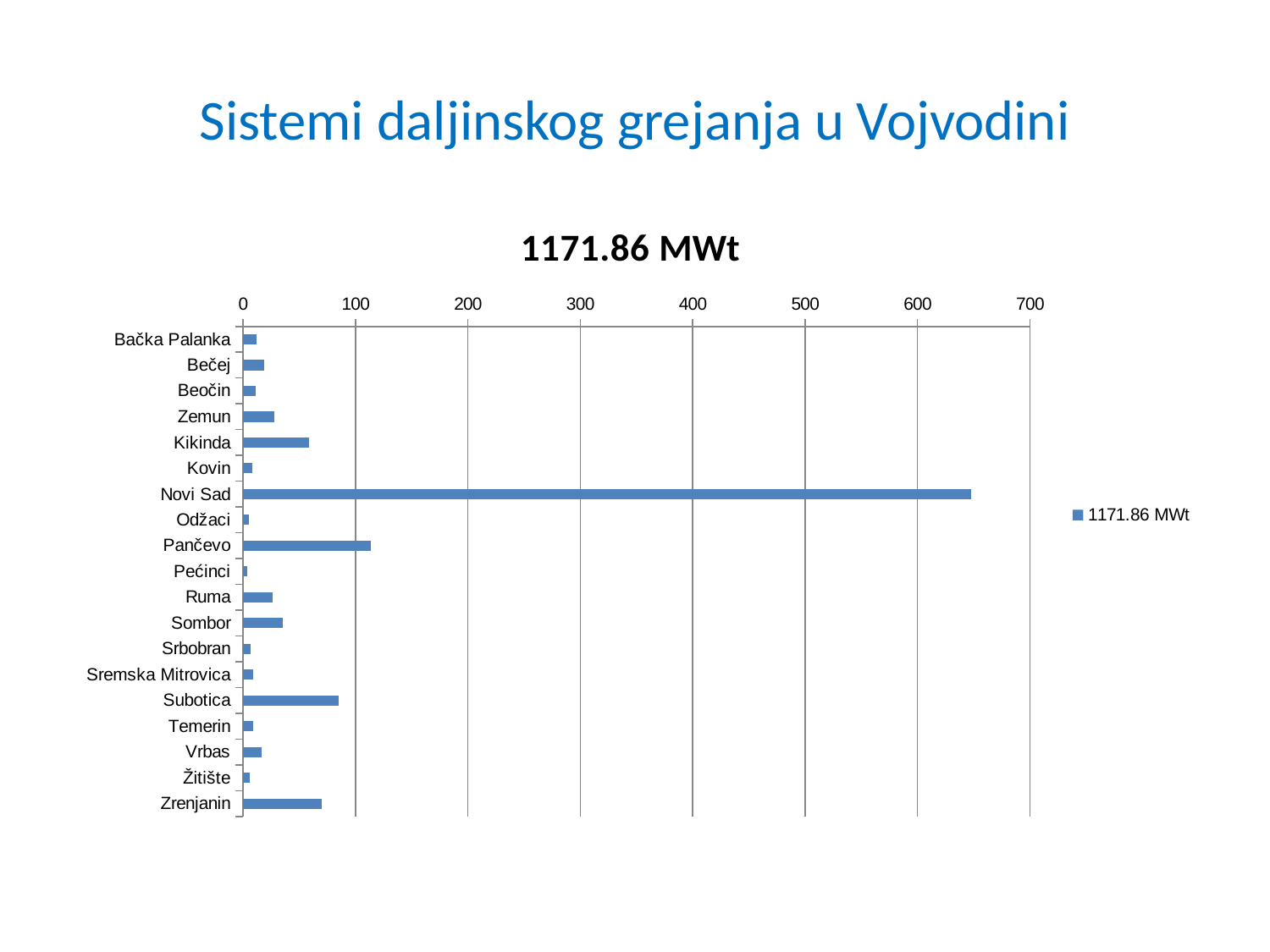
Which has the larger value, Subotica or Zrenjanin? Subotica Is the value for Subotica greater or less than 100? less Is the value for Zrenjanin greater or less than 100? less How many series does the legend list? 1 How many categories (cities) are plotted on the chart? 19 Which has the larger value, Novi Sad or Pančevo? Novi Sad Is the value for Pančevo greater or less than 100? greater What is the title of the chart? 1171.86 MWt Which has the larger value, Kikinda or Sombor? Kikinda Which city has the highest value on the chart? Novi Sad What kind of chart is shown on the slide? bar chart